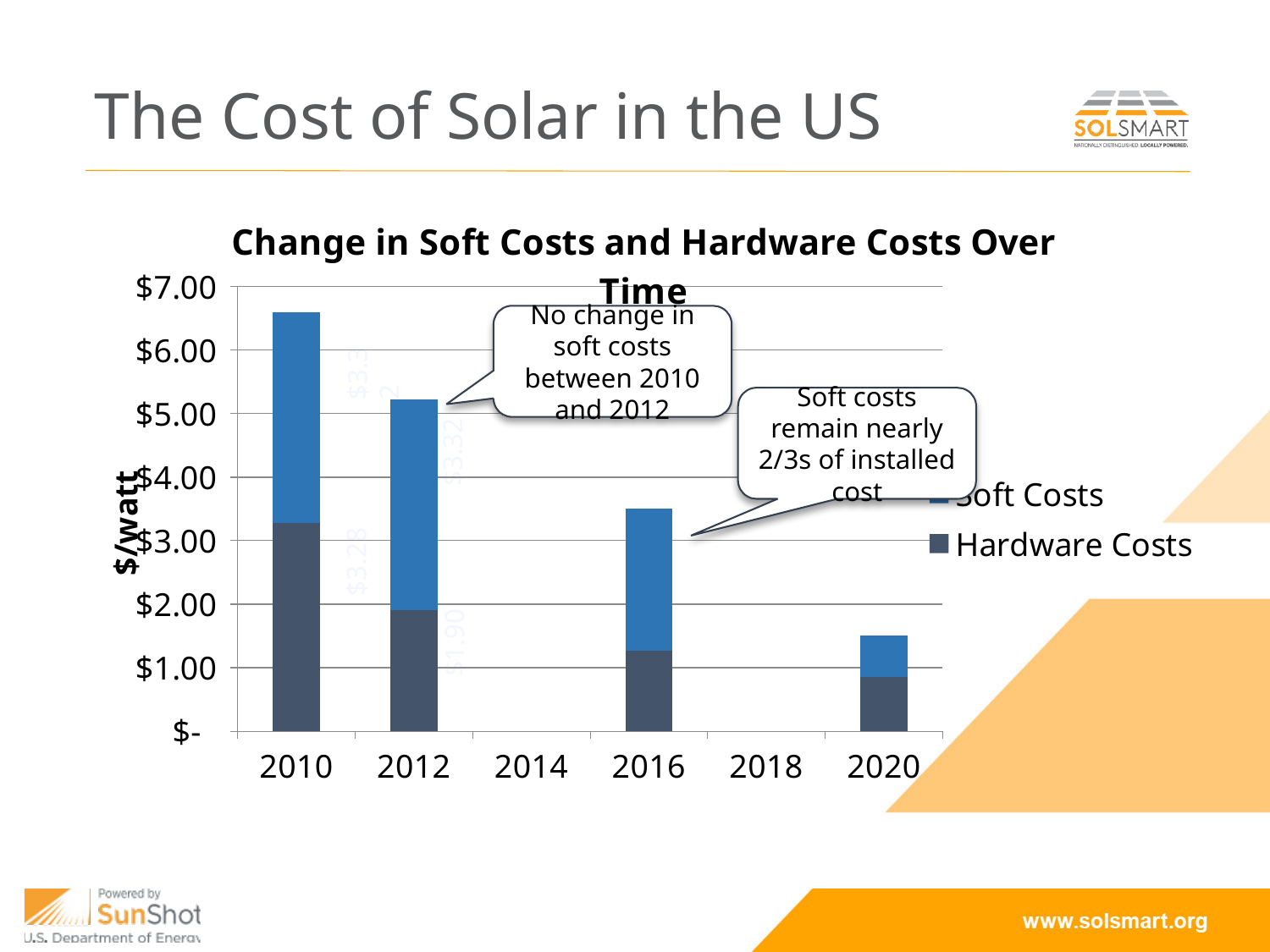
Do total costs rise or fall from 2010 to 2020? fall Is the total cost for 2010 greater or less than $6.00? greater What type of chart is shown on the slide? stacked bar chart Which year has the highest total installed cost? 2010 How many series does the chart legend list? 2 What is the title of the chart? Change in Soft Costs and Hardware Costs Over Time Which year has the lowest total installed cost? 2020 Which is larger, the total cost for 2012 or the total cost for 2016? 2012 Is the Hardware Costs value for 2020 greater or less than $1.00? less Is the total cost for 2020 greater or less than $2.00? less How many years have bars plotted in the chart? 4